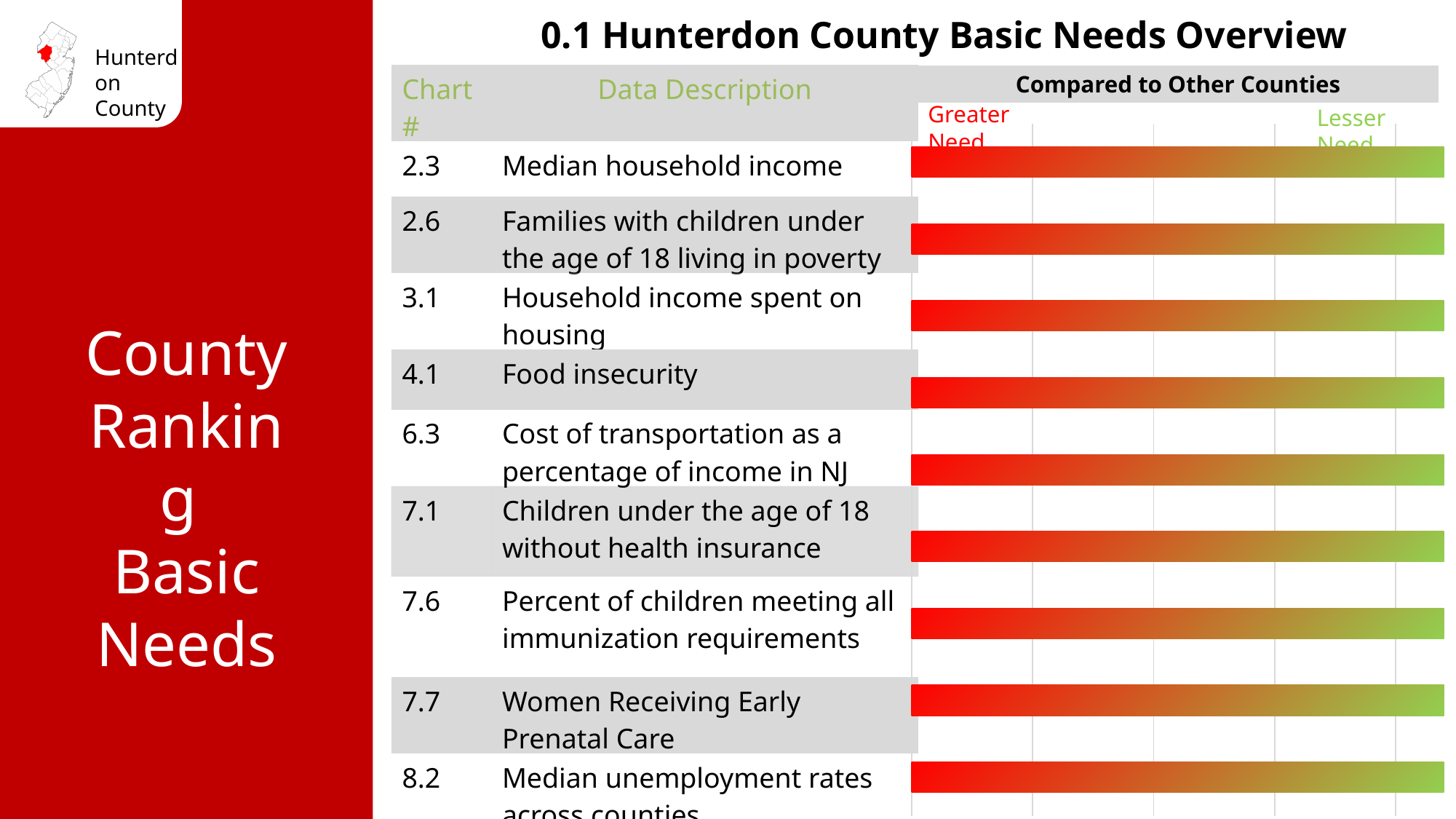
Which chart number is listed for the row 'Food insecurity'? 4.1 How many bars are plotted in the chart? 9 What label appears at the left end of the chart's scale, above the bars? Greater Need What kind of chart is shown on the slide? bar chart Which chart number is listed for the row 'Median household income'? 2.3 Which data description is listed for chart number 7.7? Women Receiving Early Prenatal Care Which data description is listed for chart number 3.1? Household income spent on housing